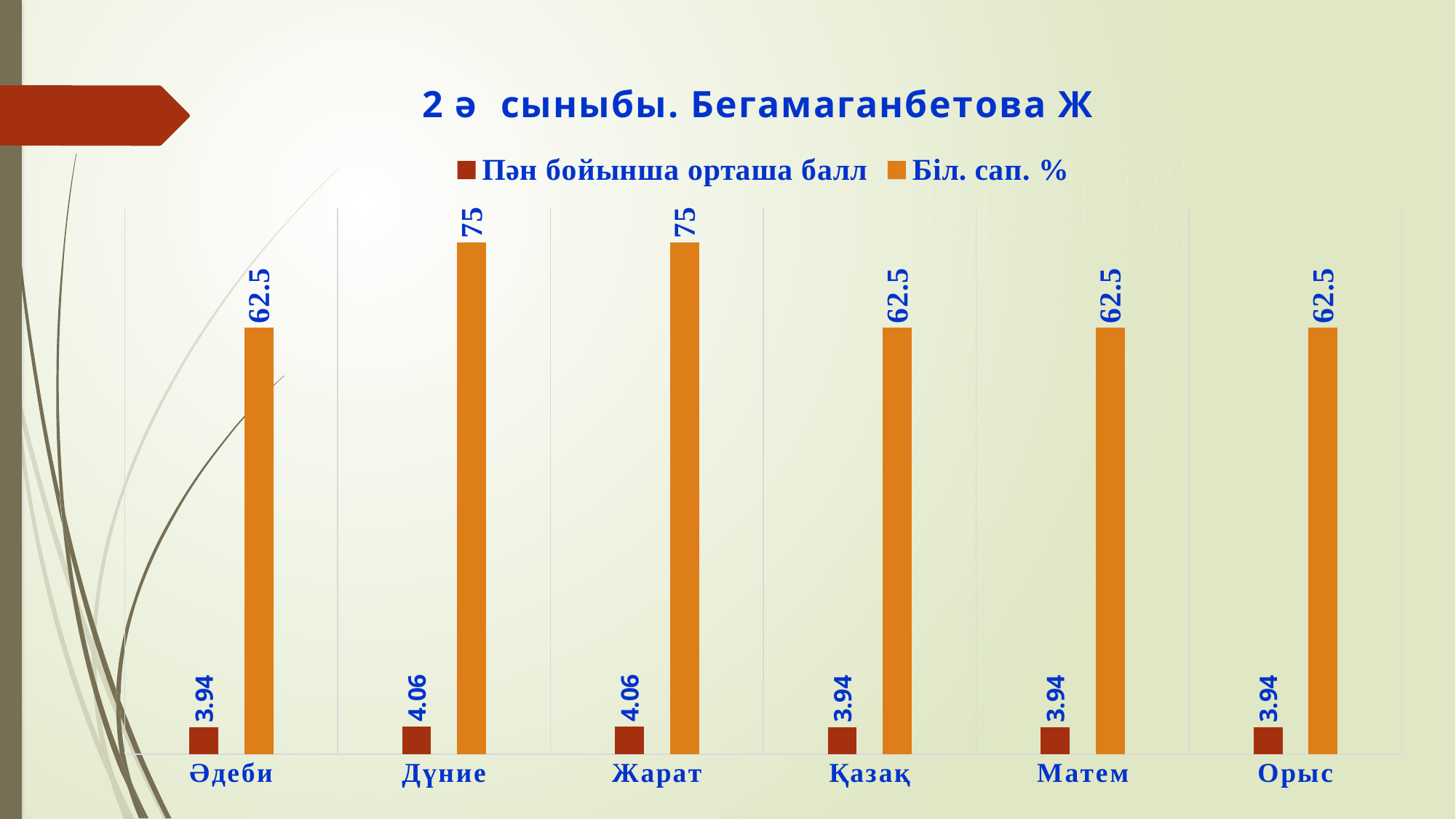
What is the value of "Пән бойынша орташа балл" for Қазақ? 3.94 What is the difference between the "Пән бойынша орташа балл" values for Дүние and Матем? 0.12 How many series does the legend list? 2 How many categories are shown on the x axis? 6 What is the title of the chart? 2 ә сыныбы. Бегамаганбетова Ж Which is larger: the "Біл. сап. %" value for Жарат or for Матем? Жарат What kind of chart is shown on the slide? Bar chart Which categories have the highest value of "Біл. сап. %"? Дүние and Жарат What is the value of "Біл. сап. %" for Дүние? 75 What is the value of "Біл. сап. %" for Орыс? 62.5 What is the difference between the "Біл. сап. %" values for Дүние and Әдеби? 12.5 What is the value of "Пән бойынша орташа балл" for Жарат? 4.06